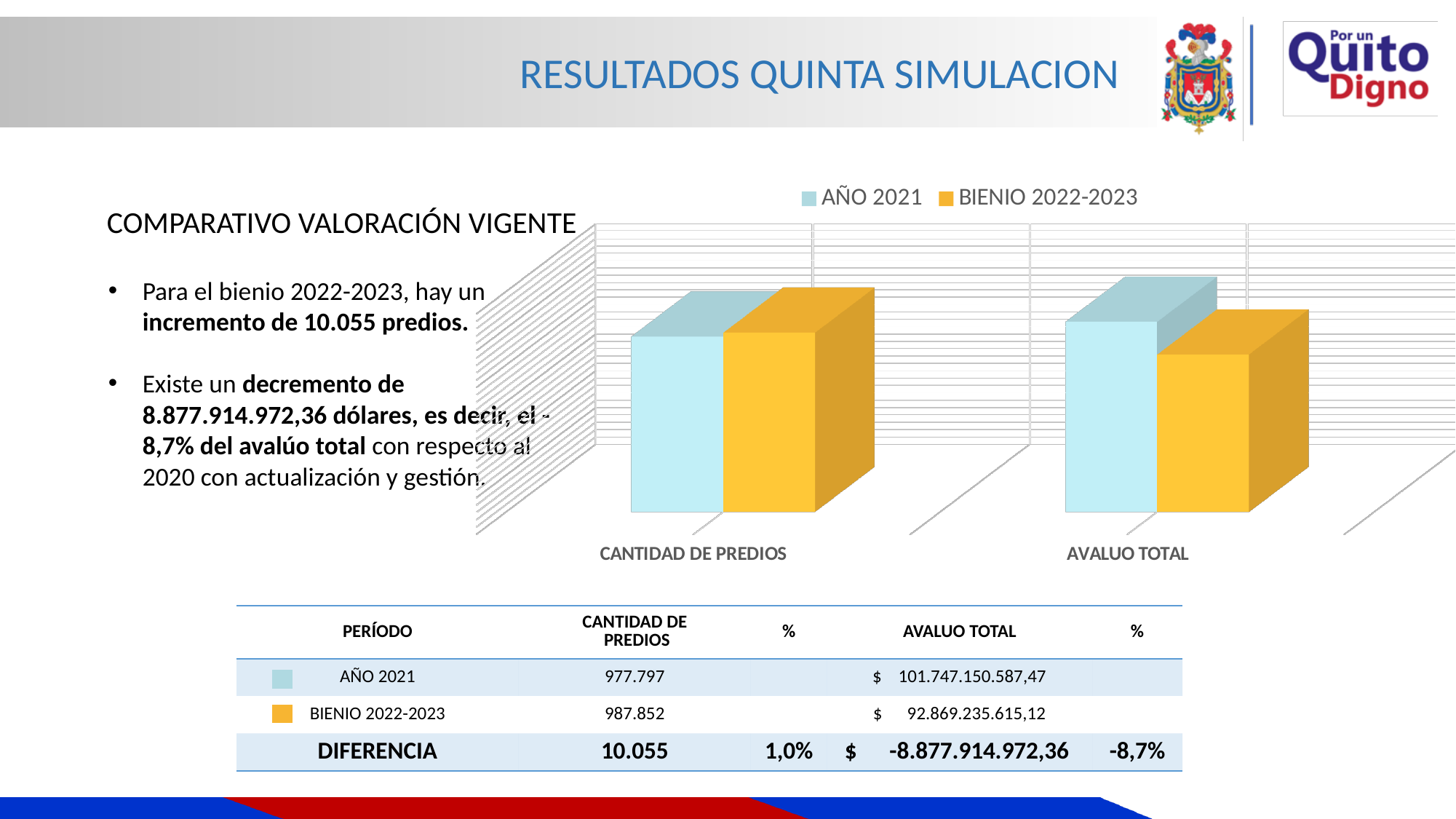
What are the two categories shown on the x axis of the chart? CANTIDAD DE PREDIOS and AVALUO TOTAL What is the difference in CANTIDAD DE PREDIOS between BIENIO 2022-2023 and AÑO 2021, as shown in the DIFERENCIA row? 10.055 What kind of chart is shown on the slide? bar chart According to the table below the chart, what is the AVALUO TOTAL for BIENIO 2022-2023? $ 92.869.235.615,12 Which series is shown in yellow/orange in the chart? BIENIO 2022-2023 How many categories are shown on the x axis of the chart? 2 For AVALUO TOTAL, which series has the taller bar, AÑO 2021 or BIENIO 2022-2023? AÑO 2021 What is the percentage difference in AVALUO TOTAL shown in the DIFERENCIA row of the table? -8,7% According to the table below the chart, what is the CANTIDAD DE PREDIOS value for BIENIO 2022-2023? 987.852 How many series does the chart legend list? 2 According to the table below the chart, what is the CANTIDAD DE PREDIOS value for AÑO 2021? 977.797 According to the table below the chart, what is the AVALUO TOTAL for AÑO 2021? $ 101.747.150.587,47